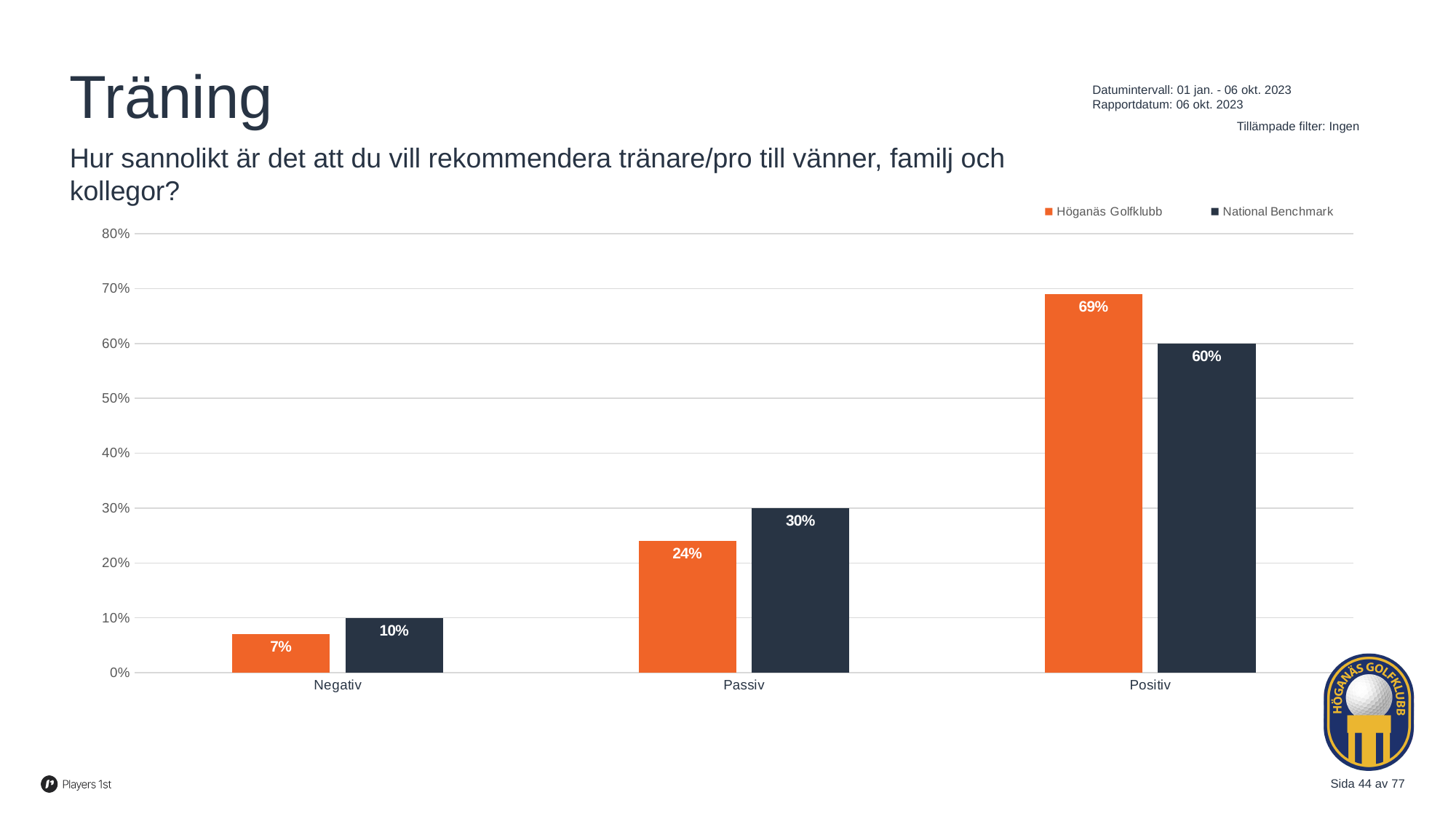
What is the value for Höganäs Golfklubb in the Negativ category? 7% Which category has the highest value for National Benchmark? Positiv What is the difference between Höganäs Golfklubb and National Benchmark in the Positiv category? 9% What is the value for Höganäs Golfklubb in the Positiv category? 69% What is the value for National Benchmark in the Passiv category? 30% Is the value for National Benchmark in the Negativ category greater or less than 20%? less How many categories are shown on the x axis? 3 Which category has the lowest value for Höganäs Golfklubb? Negativ How many series does the legend list? 2 Which colour represents Höganäs Golfklubb in the chart? orange What kind of chart is shown on the slide? bar chart In the Passiv category, which series has the larger value, Höganäs Golfklubb or National Benchmark? National Benchmark